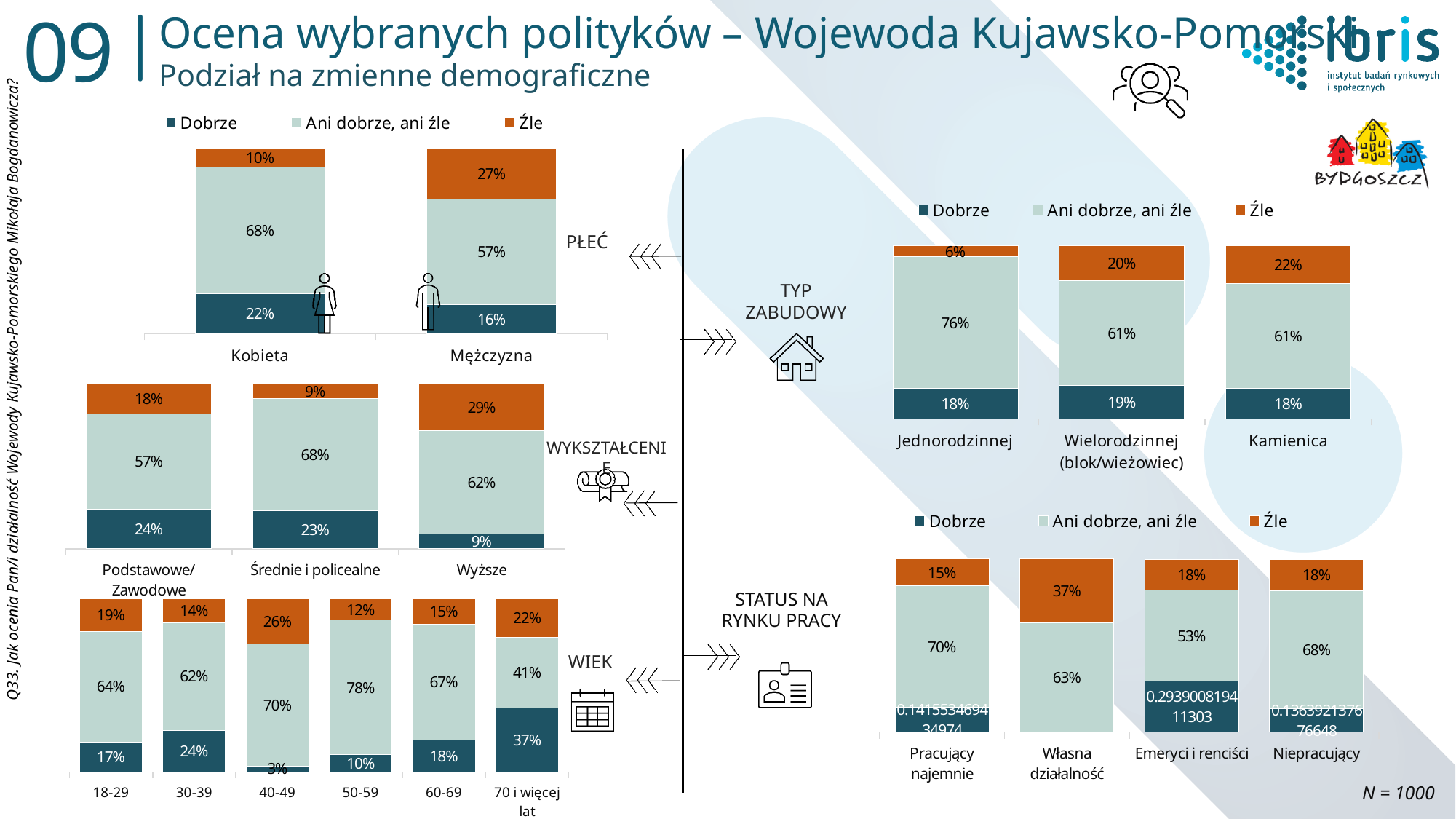
In the TYP ZABUDOWY chart, which has the larger Ani dobrze, ani źle value: Jednorodzinnej or Kamienica? Jednorodzinnej In the PŁEĆ chart, what percentage of Kobieta respondents answered Dobrze? 22% In the WYKSZTAŁCENIE chart, which education category has the highest Źle value? Wyższe In the WIEK chart, what is the Ani dobrze, ani źle value for the 50-59 age group? 78% In the TYP ZABUDOWY chart, what is the Źle value for Jednorodzinnej? 6% In the PŁEĆ chart, what is the difference between the Ani dobrze, ani źle values for Kobieta and Mężczyzna? 11 percentage points In the WYKSZTAŁCENIE chart, what is the Dobrze value for Wyższe? 9% In the STATUS NA RYNKU PRACY chart, what is the Źle value for Własna działalność? 37% How many series does the legend of the PŁEĆ chart list? 3 In the PŁEĆ chart, what is the Źle value for Mężczyzna? 27% In the WIEK chart, which age group has the highest Dobrze value? 70 i więcej lat In the WIEK chart, which age group has the lowest Dobrze value? 40-49